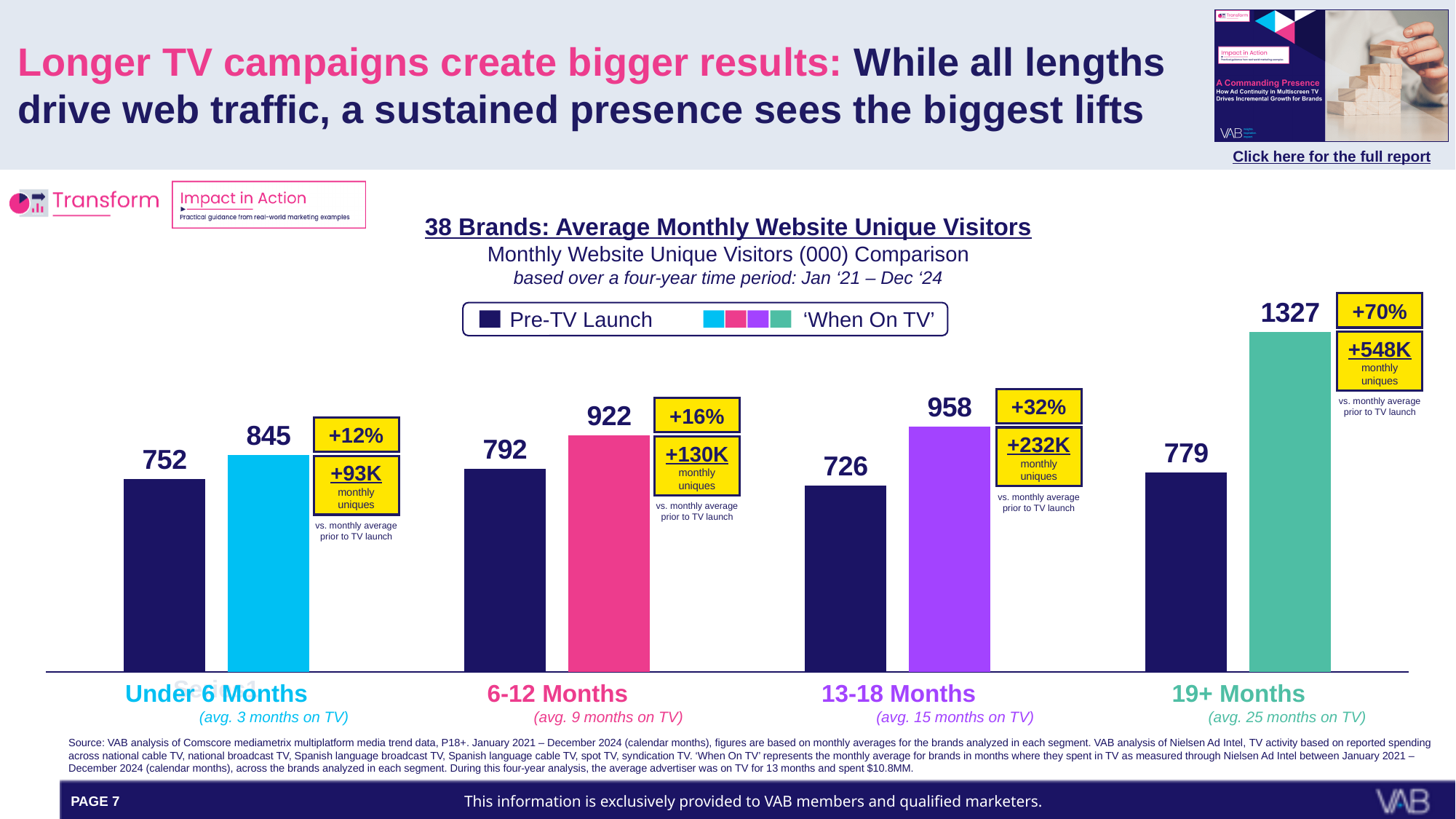
What is the title of the chart? 38 Brands: Average Monthly Website Unique Visitors What is the 'When On TV' value for the 19+ Months category? 1327 How many campaign-length categories are shown on the x axis? 4 Which category has the highest 'When On TV' value? 19+ Months Which category has the lowest Pre-TV Launch value? 13-18 Months What is the Pre-TV Launch value for the 13-18 Months category? 726 Which is larger: the Pre-TV Launch value for 6-12 Months or the Pre-TV Launch value for 19+ Months? 6-12 Months What is the difference between the 'When On TV' and Pre-TV Launch values for the 13-18 Months category? 232 How many series does the legend list? 2 What kind of chart is shown on the slide? Bar chart What percentage lift in monthly uniques is shown for the Under 6 Months category? +12% What is the 'When On TV' value for the 6-12 Months category? 922